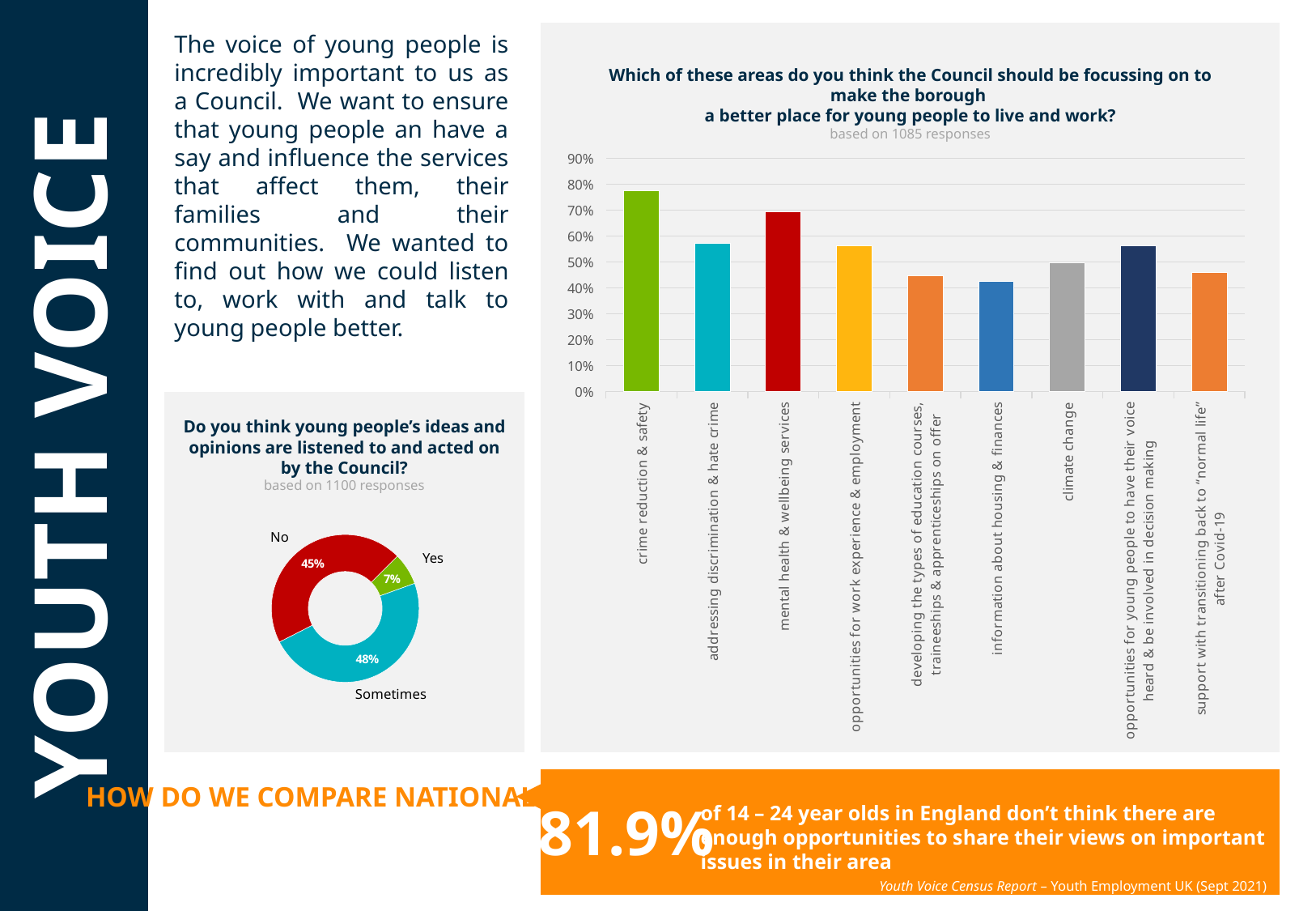
In the bar chart 'Which of these areas do you think the Council should be focussing on...', how many areas are shown? 9 In the donut chart 'Do you think young people's ideas and opinions are listened to and acted on by the Council?', what percentage answered 'No'? 45% In the donut chart 'Do you think young people's ideas and opinions are listened to and acted on by the Council?', what percentage answered 'Sometimes'? 48% In the bar chart 'Which of these areas do you think the Council should be focussing on...', which is larger: 'mental health & wellbeing services' or 'addressing discrimination & hate crime'? mental health & wellbeing services In the donut chart 'Do you think young people's ideas and opinions are listened to and acted on by the Council?', how many response categories are shown? 3 In the bar chart 'Which of these areas do you think the Council should be focussing on...', is the value for 'crime reduction & safety' greater or less than 70%? greater In the bar chart 'Which of these areas do you think the Council should be focussing on...', which area has the highest value? crime reduction & safety What kind of chart is the chart titled 'Which of these areas do you think the Council should be focussing on...'? bar chart In the donut chart 'Do you think young people's ideas and opinions are listened to and acted on by the Council?', what percentage answered 'Yes'? 7% In the donut chart 'Do you think young people's ideas and opinions are listened to and acted on by the Council?', which response has the smallest share? Yes In the bar chart 'Which of these areas do you think the Council should be focussing on...', is the value for 'information about housing & finances' greater or less than 50%? less In the donut chart 'Do you think young people's ideas and opinions are listened to and acted on by the Council?', what is the difference in percentage points between 'Sometimes' and 'No'? 3 percentage points